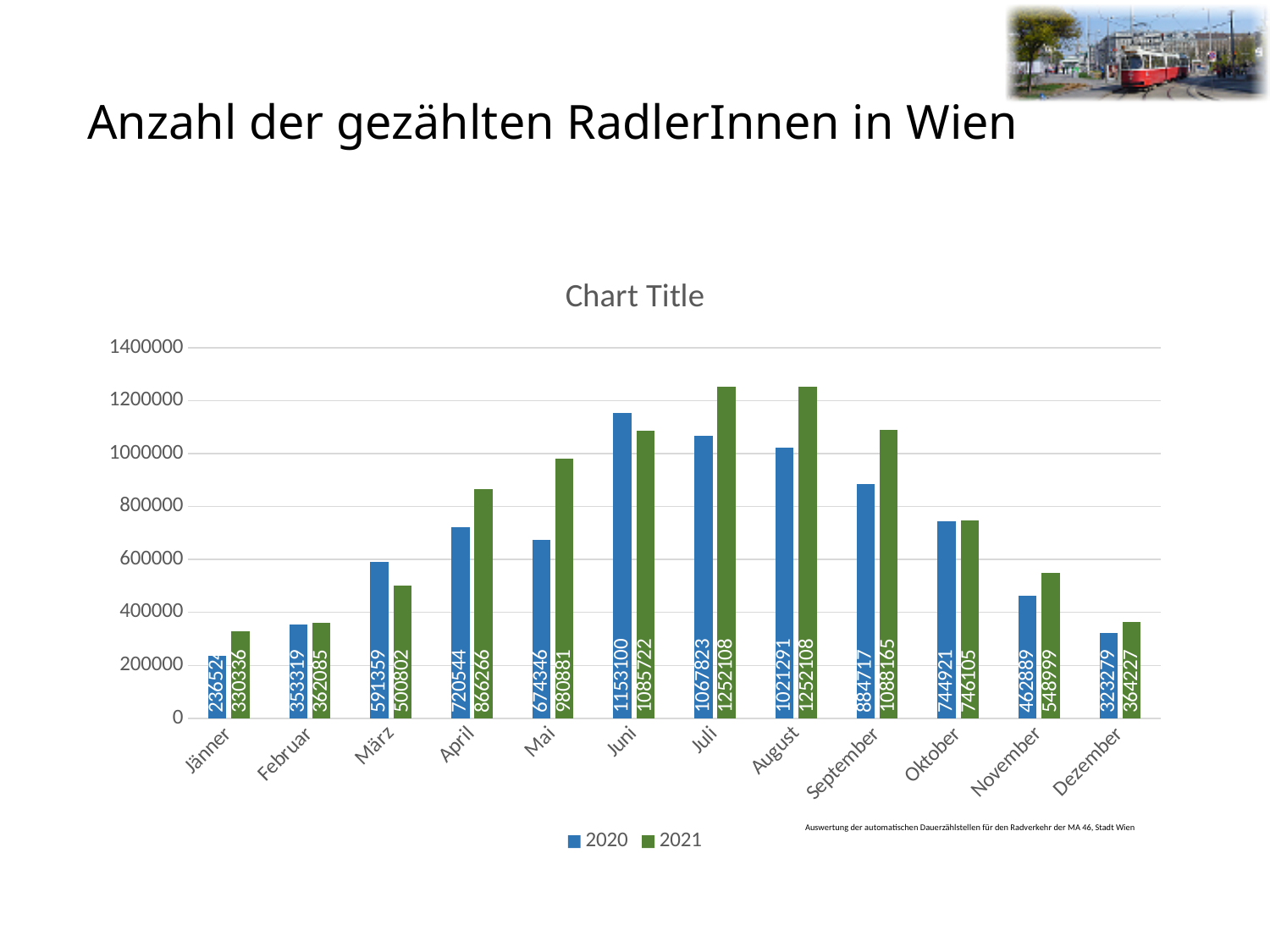
What is the difference between the 2021 and 2020 values in Mai? 306535 What is the value for 2021 in September? 1088165 Which month has the highest value for 2020? Juni How many series does the legend list? 2 Which is larger in Juni, the 2020 value or the 2021 value? 2020 How many months are shown on the x axis? 12 Is the value for 2021 in April greater or less than 800000? greater What kind of chart is shown on the slide? bar chart What is the value for 2021 in Mai? 980881 Which month has the lowest value for 2021? Jänner What is the value for 2020 in November? 462889 What is the value for 2020 in Juni? 1153100